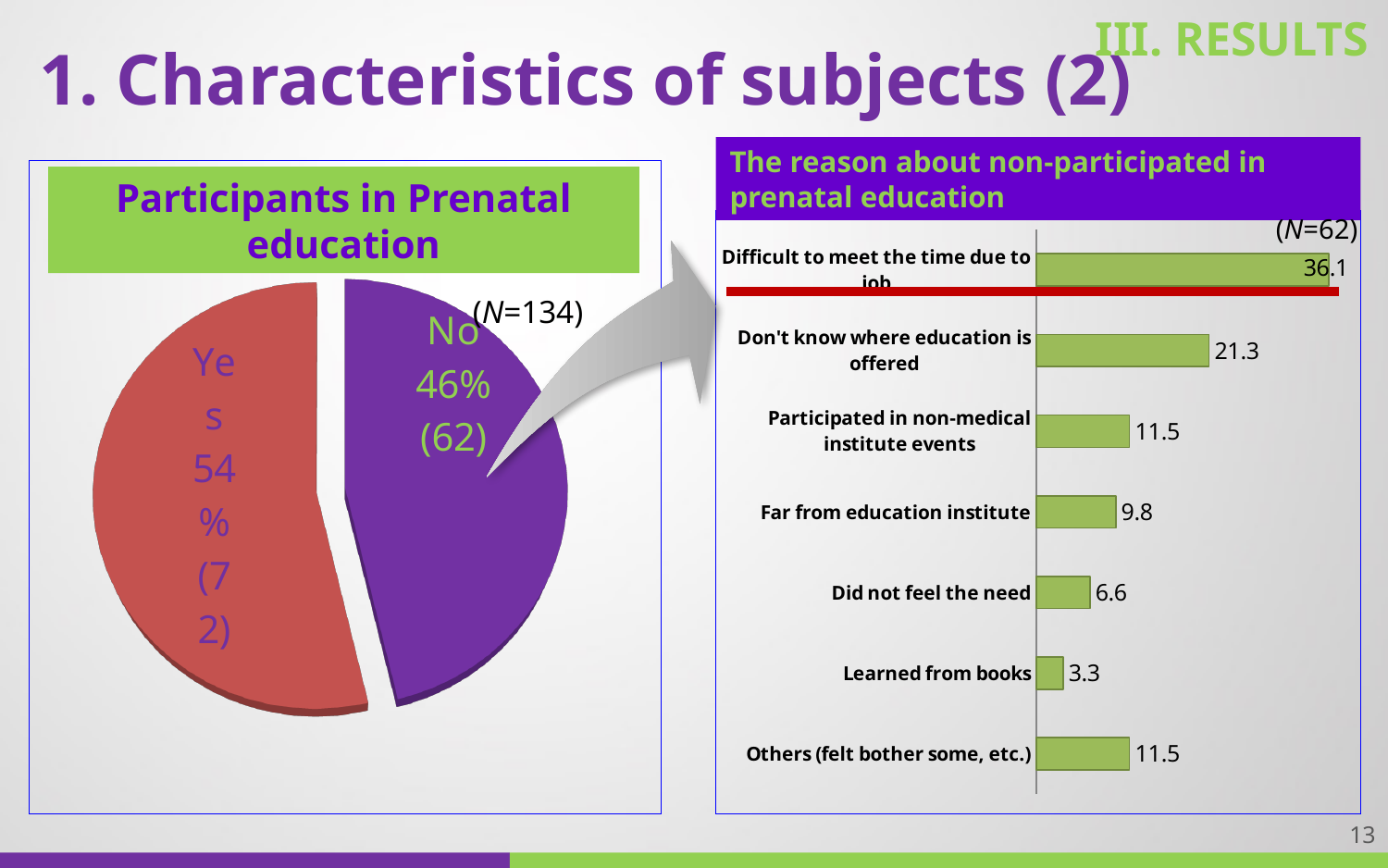
How many reasons (categories) are shown in the bar chart 'The reason about non-participated in prenatal education'? 7 In the 'Participants in Prenatal education' pie chart, what percentage of participants answered No? 46% In the bar chart 'The reason about non-participated in prenatal education', what is the value for 'Don't know where education is offered'? 21.3 In the bar chart 'The reason about non-participated in prenatal education', what is the value for 'Far from education institute'? 9.8 In the bar chart 'The reason about non-participated in prenatal education', which reason has the highest value? Difficult to meet the time due to job In the 'Participants in Prenatal education' pie chart, which slice is larger, Yes or No? Yes In the 'Participants in Prenatal education' pie chart, how many respondents answered No? 62 In the bar chart 'The reason about non-participated in prenatal education', which reason has the lowest value? Learned from books In the 'Participants in Prenatal education' pie chart, what percentage of participants answered Yes? 54% What kind of chart is 'The reason about non-participated in prenatal education'? Bar chart What kind of chart is 'Participants in Prenatal education'? Pie chart In the bar chart 'The reason about non-participated in prenatal education', what is the difference between 'Difficult to meet the time due to job' and 'Don't know where education is offered'? 14.8